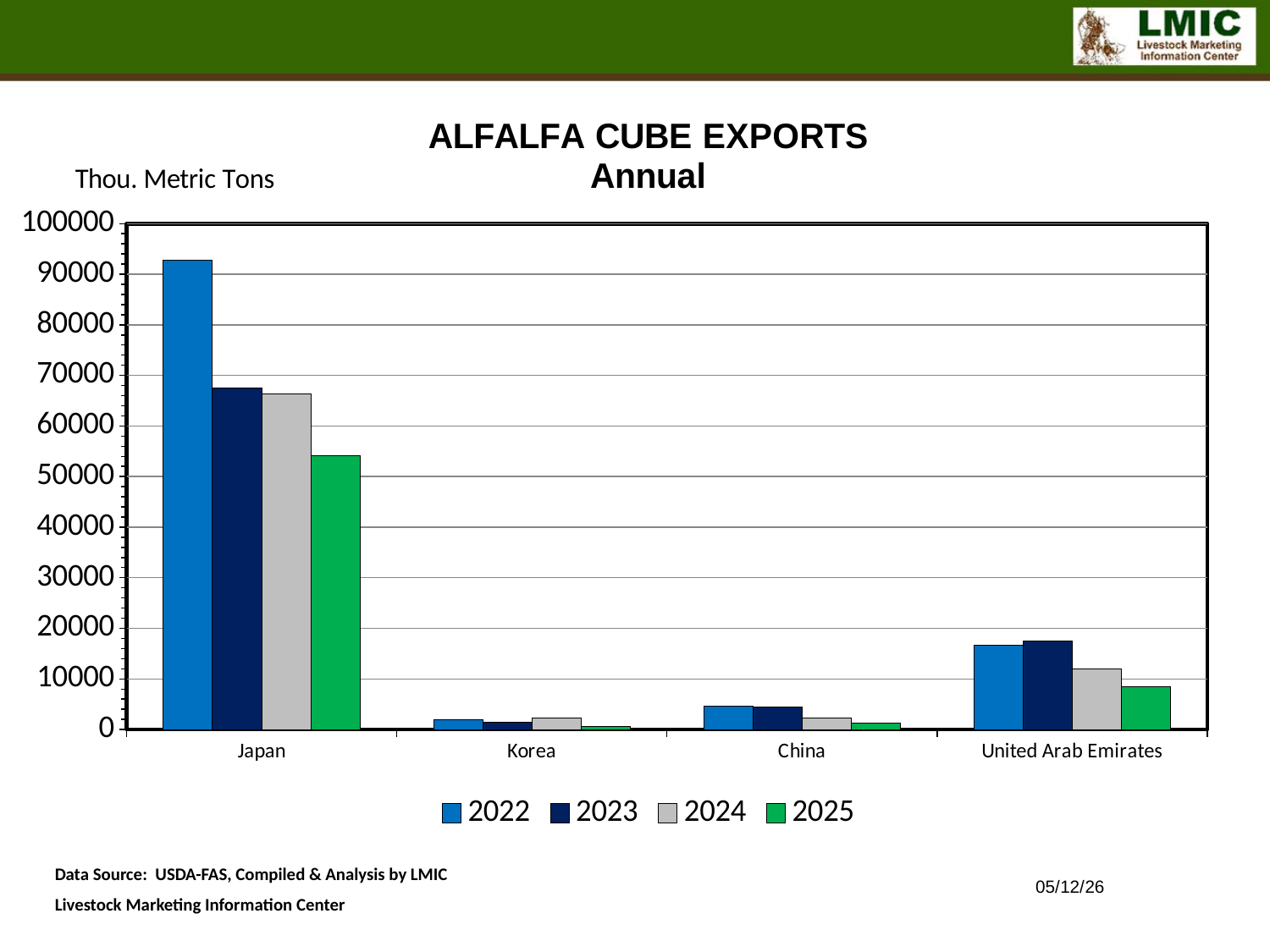
Is the value for United Arab Emirates in 2023 greater or less than 20000? less Do Japan's export values rise or fall from 2022 to 2025? fall Is the value for Japan in 2022 greater or less than 90000? greater How many countries are shown on the x axis of the chart? 4 Which country has the highest alfalfa cube exports in 2022? Japan What kind of chart is shown on the slide? bar chart Which country has the larger 2022 value: China or United Arab Emirates? United Arab Emirates Is the value for Japan in 2025 greater or less than 50000? greater How many series does the legend list? 4 Which is larger for Japan: the 2022 value or the 2025 value? 2022 What unit label is shown above the y axis of the chart? Thou. Metric Tons